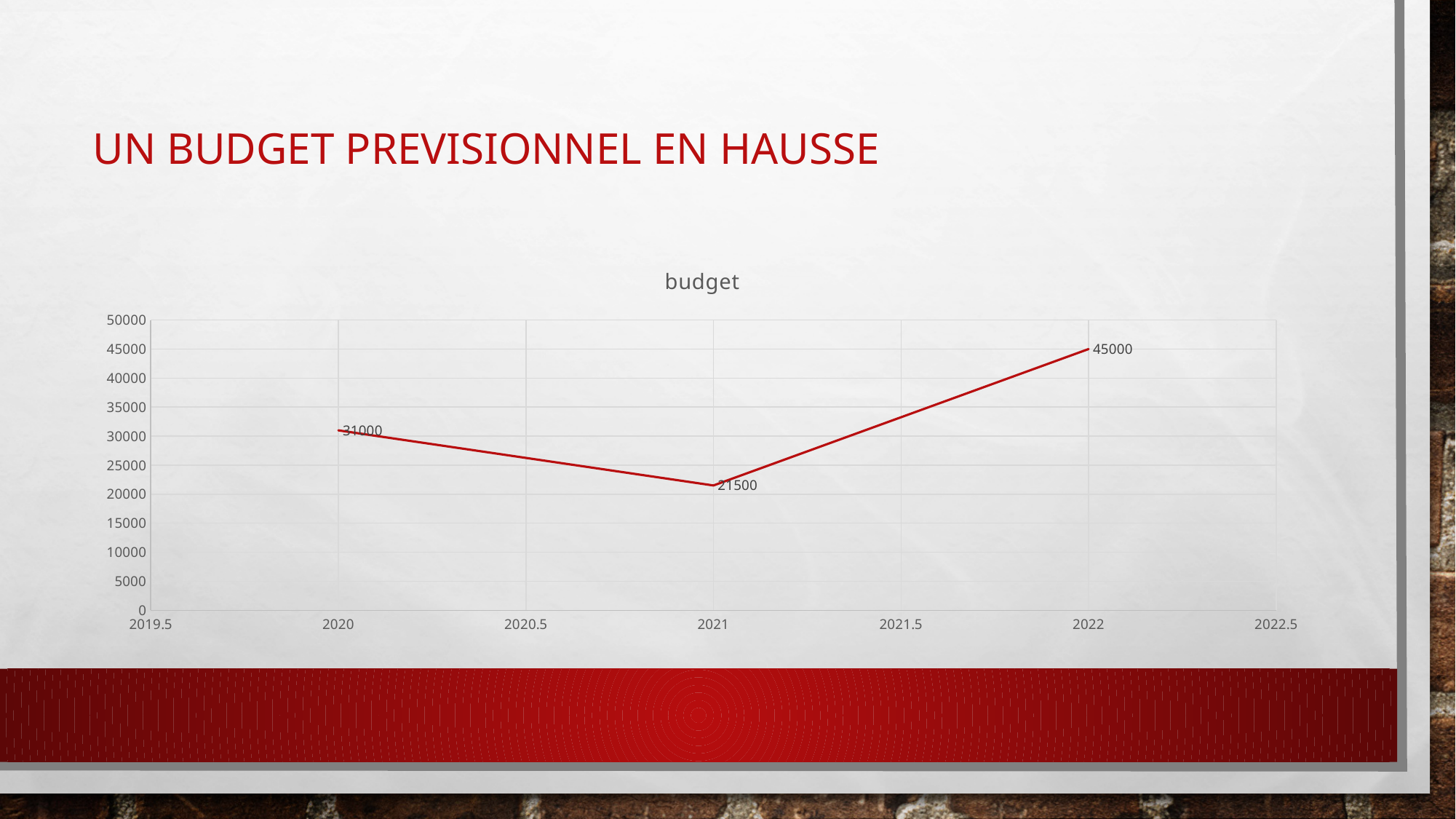
What is the budget value for 2021? 21500 What is the title of the chart? budget What is the difference between the budget values for 2022 and 2021? 23500 Which year has the lowest budget value? 2021 What is the budget value for 2020? 31000 Which year has the highest budget value? 2022 What is the difference between the budget values for 2020 and 2021? 9500 Which is larger, the budget value for 2020 or for 2022? 2022 Is the budget value for 2021 greater or less than 25000? less What is the budget value for 2022? 45000 How many data points are plotted on the chart? 3 What kind of chart is shown on the slide? line chart